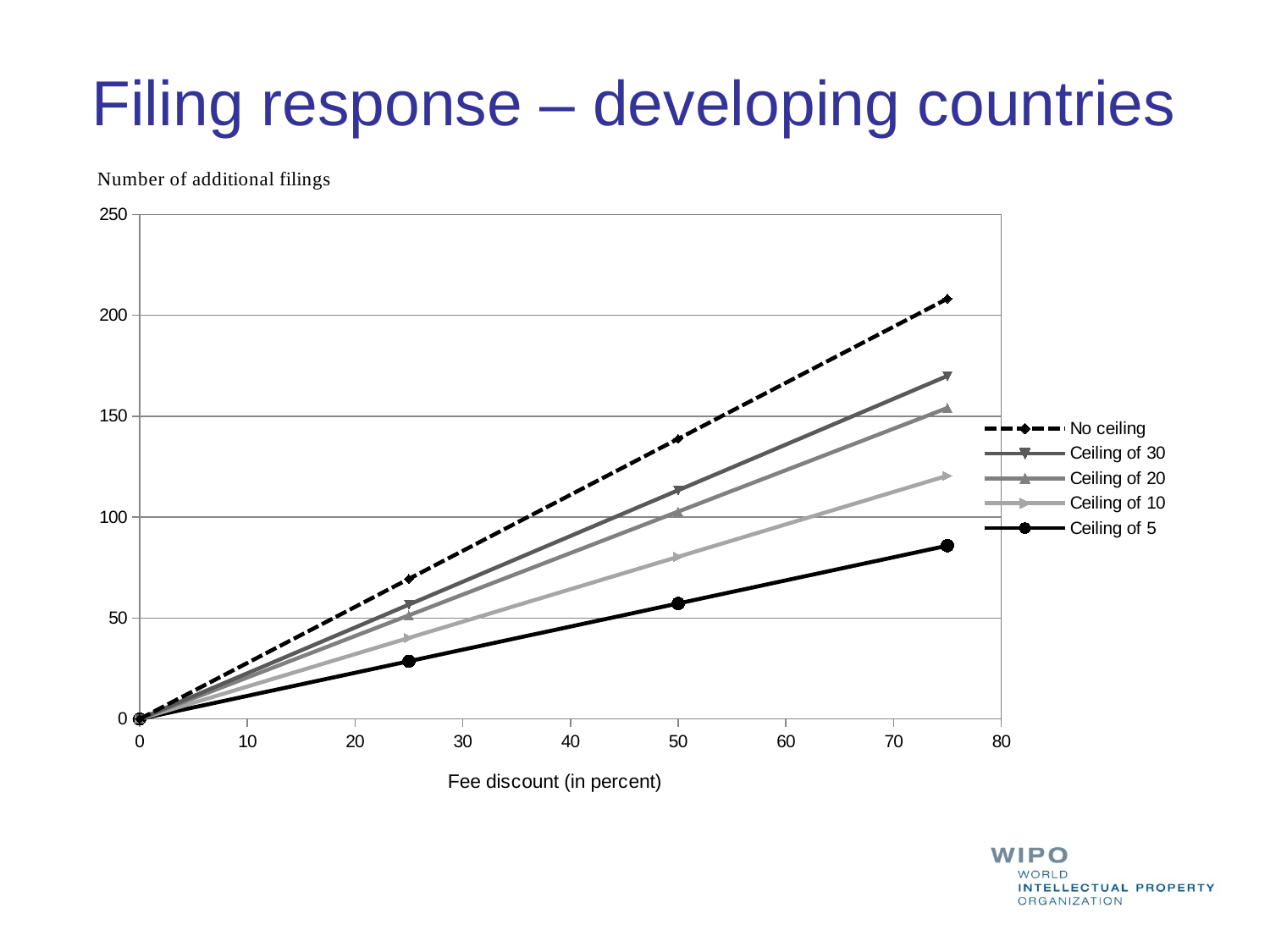
Is the value for No ceiling at a fee discount of 50 percent greater or less than 150? less What is the title of the x axis? Fee discount (in percent) At a fee discount of 50 percent, which is larger: the value for Ceiling of 30 or the value for Ceiling of 10? Ceiling of 30 Is the value for Ceiling of 5 at a fee discount of 75 percent greater or less than 100? less Is the value for Ceiling of 10 at a fee discount of 50 percent greater or less than 100? less How many series does the legend list? 5 Which series has the lowest number of additional filings at a fee discount of 75 percent? Ceiling of 5 What kind of chart is shown on the slide? line chart Do the number of additional filings rise or fall as the fee discount increases? rise Which series has the highest number of additional filings at a fee discount of 75 percent? No ceiling